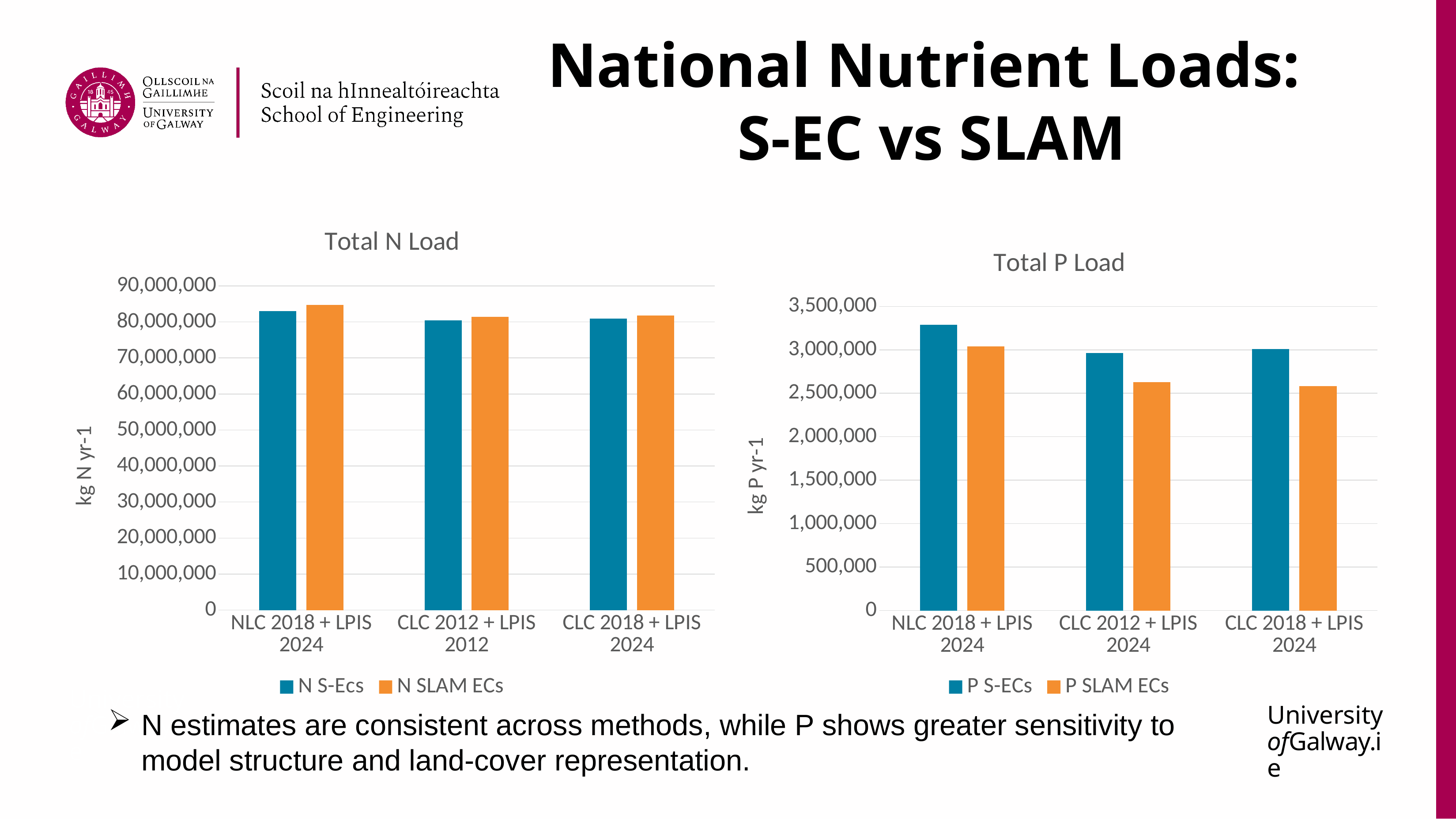
In the Total P Load chart, which category has the highest P S-ECs value? NLC 2018 + LPIS 2024 In the Total N Load chart, is the N SLAM ECs value for NLC 2018 + LPIS 2024 greater or less than 90,000,000? less In the Total P Load chart, for NLC 2018 + LPIS 2024, which is larger: P S-ECs or P SLAM ECs? P S-ECs In the Total P Load chart, is the P SLAM ECs value for CLC 2012 + LPIS 2024 greater or less than 3,000,000? less How many categories are shown on the x axis of the Total P Load chart? 3 In the Total P Load chart, is the P SLAM ECs value for CLC 2018 + LPIS 2024 greater or less than 2,500,000? greater What is the y-axis label of the Total P Load chart? kg P yr-1 How many series does the legend of the Total N Load chart list? 2 What kind of chart is the Total N Load chart? bar chart In the Total P Load chart, for CLC 2012 + LPIS 2024, which is larger: P S-ECs or P SLAM ECs? P S-ECs